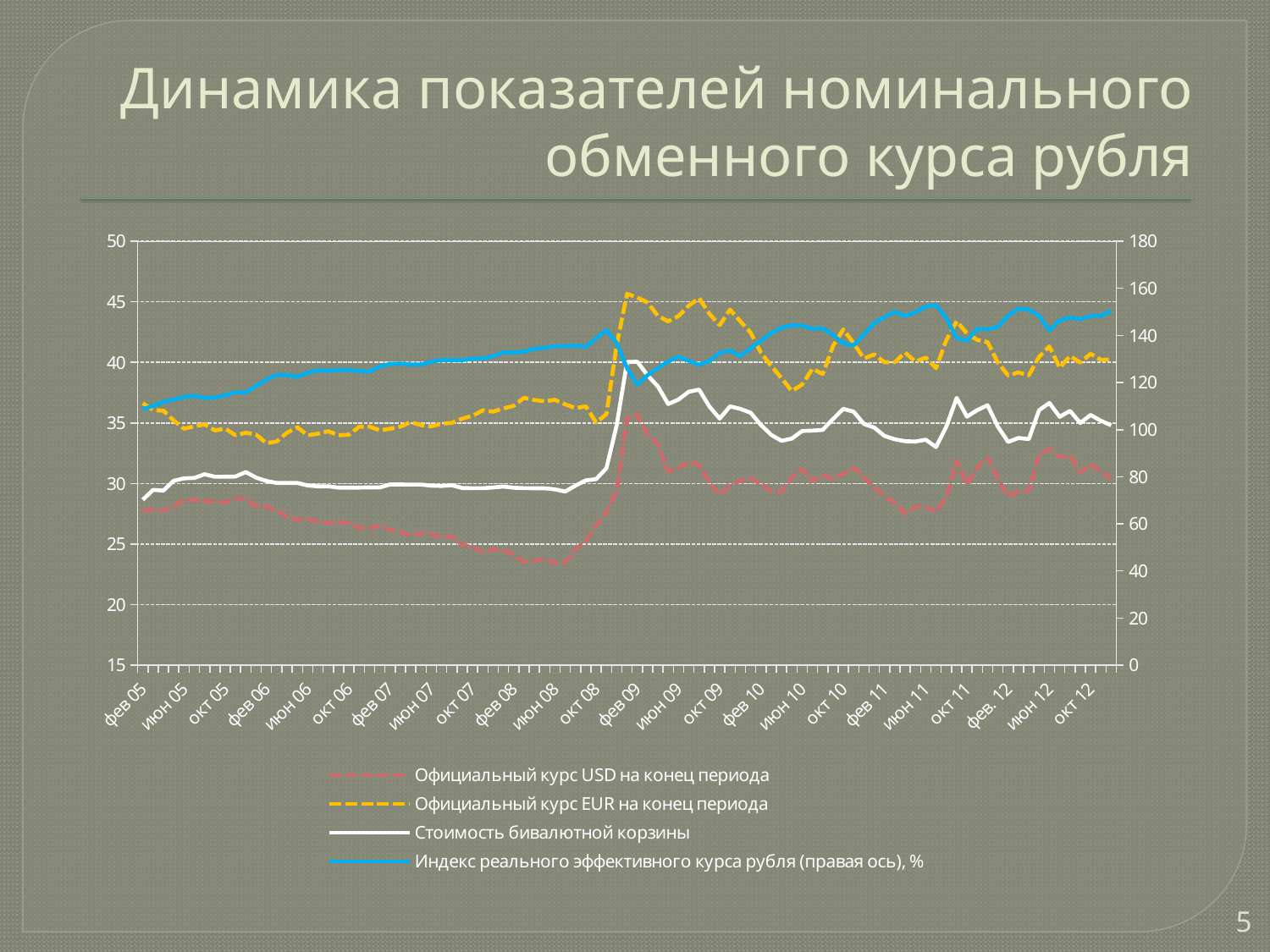
Is the value of the bi-currency basket (Стоимость бивалютной корзины) in фев 05 greater or less than 30? less Is the value of the official EUR rate (Официальный курс EUR на конец периода) in фев 09 greater or less than 40? greater Is the value of the real effective exchange rate index (right axis) in фев 05 greater or less than 100? greater Does the real effective exchange rate index rise or fall from фев 05 to окт 08? rise In фев 09, which is higher: the official USD rate or the official EUR rate? Официальный курс EUR на конец периода Does the official USD rate rise or fall from фев 05 to июн 08? fall What is the title of the chart on the slide? Динамика показателей номинального обменного курса рубля Which series is plotted against the right axis? Индекс реального эффективного курса рубля (правая ось), % What kind of chart is shown on the slide? line chart How many series does the legend list? 4